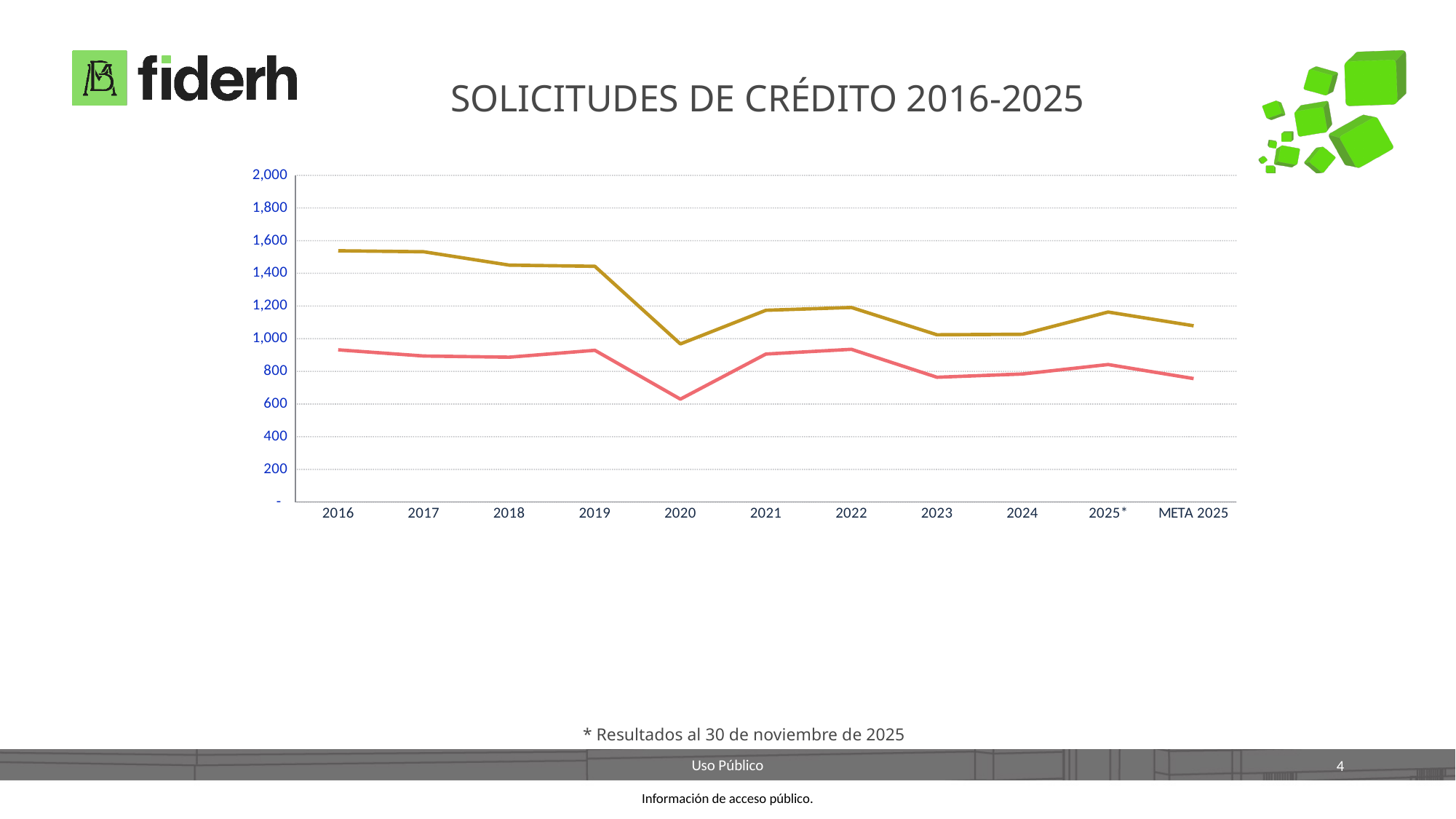
How many lines are plotted on the chart? 2 Is the value of the gold line for 2016 greater or less than 1,400? greater In which year does the gold line reach its lowest value? 2020 What is the title of the chart? SOLICITUDES DE CRÉDITO 2016-2025 How many categories are shown along the x axis? 11 In which year does the pink line reach its lowest value? 2020 Is the value of the pink line for 2020 greater or less than 800? less Does the gold line rise or fall from 2016 to 2020? fall What kind of chart is shown on the slide? line chart Which line has the higher value in 2020, the gold line or the pink line? the gold line Is the value of the pink line for 2016 greater or less than 800? greater